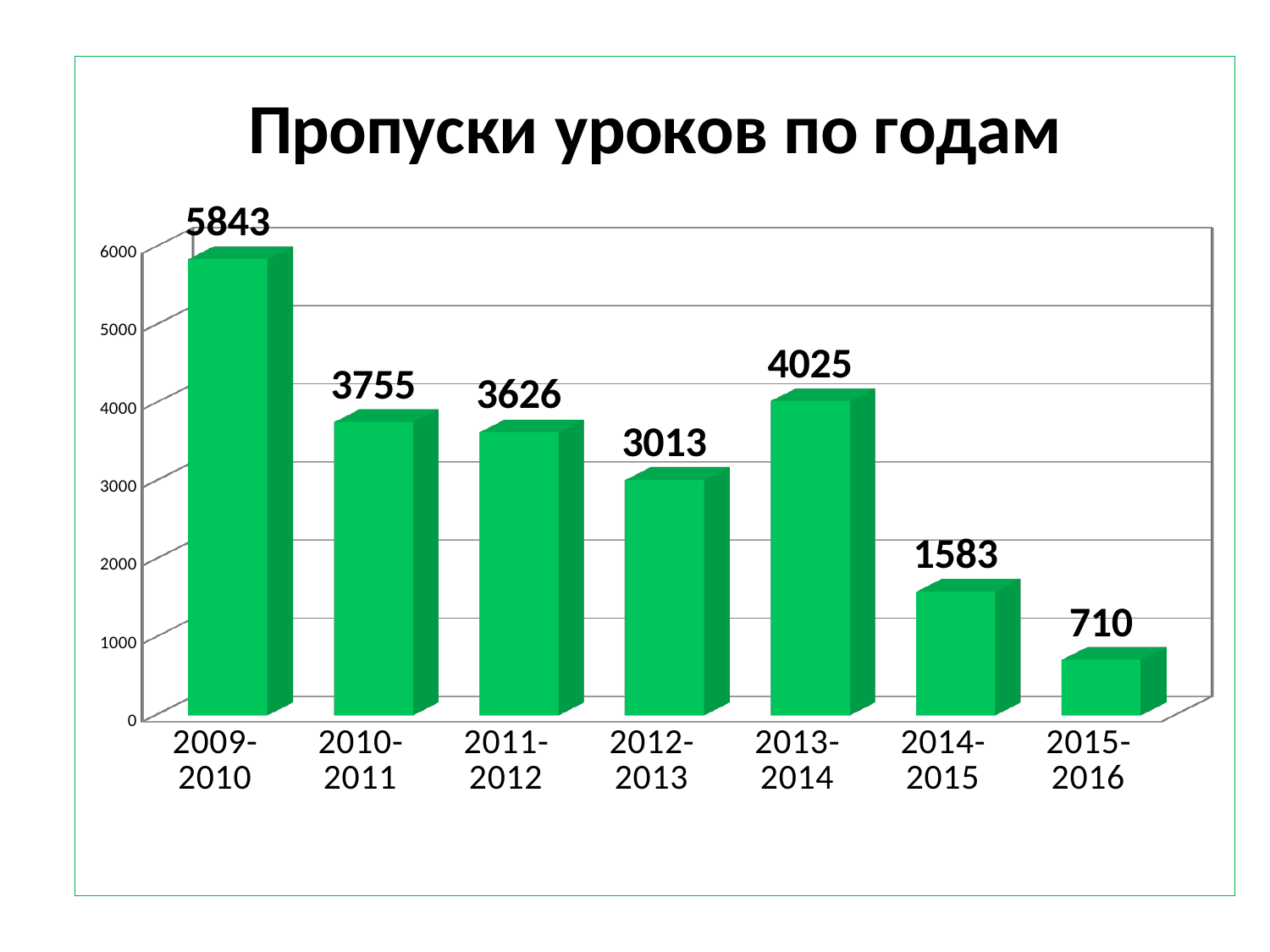
Which is larger, the value for 2012-2013 or the value for 2013-2014? 2013-2014 What is the title of the chart? Пропуски уроков по годам How many years are shown on the x axis? 7 What kind of chart is shown on the slide? bar chart What is the value for 2013-2014? 4025 Which year has the highest value? 2009-2010 Is the value for 2011-2012 greater or less than 3000? greater What is the difference between the values for 2014-2015 and 2015-2016? 873 What is the value for 2009-2010? 5843 What is the value for 2015-2016? 710 Which year has the lowest value? 2015-2016 What is the difference between the values for 2009-2010 and 2010-2011? 2088